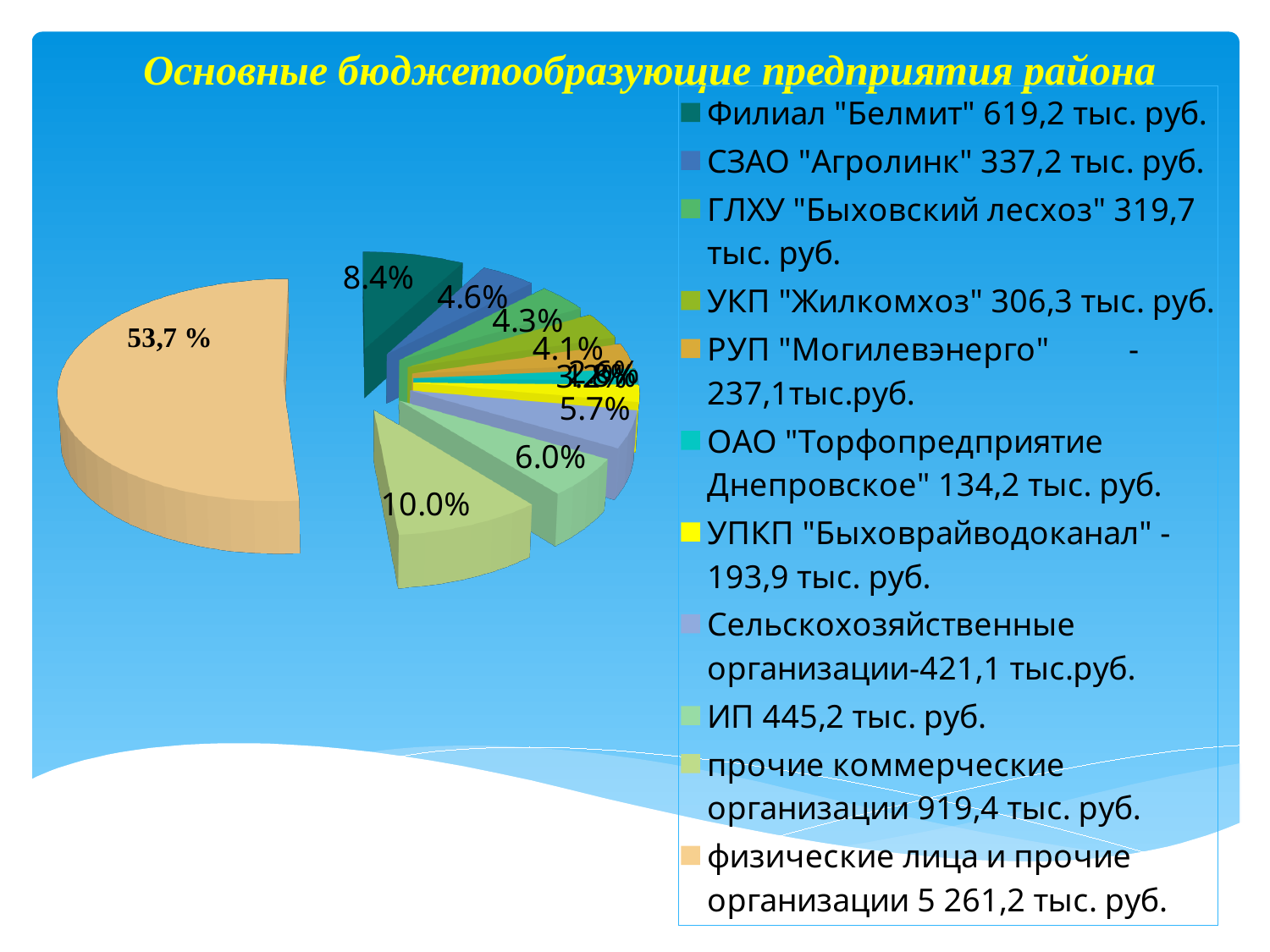
What is the title of the slide? Основные бюджетообразующие предприятия района Which is larger, the value for Филиал "Белмит" or for СЗАО "Агролинк"? Филиал "Белмит" What percentage is shown for the Филиал "Белмит" slice? 8.4% Which category has the largest slice of the pie? физические лица и прочие организации What value does the legend give for Филиал "Белмит"? 619,2 тыс. руб. Which legend entry has the smallest value? ОАО "Торфопредприятие Днепровское" (134,2 тыс. руб.) What share of the pie is labelled for физические лица и прочие организации? 53,7 % What kind of chart is shown on the slide? Pie chart How many entries does the chart legend list? 11 What value does the legend give for физические лица и прочие организации? 5 261,2 тыс. руб. What percentage is shown for the ИП slice? 6.0%